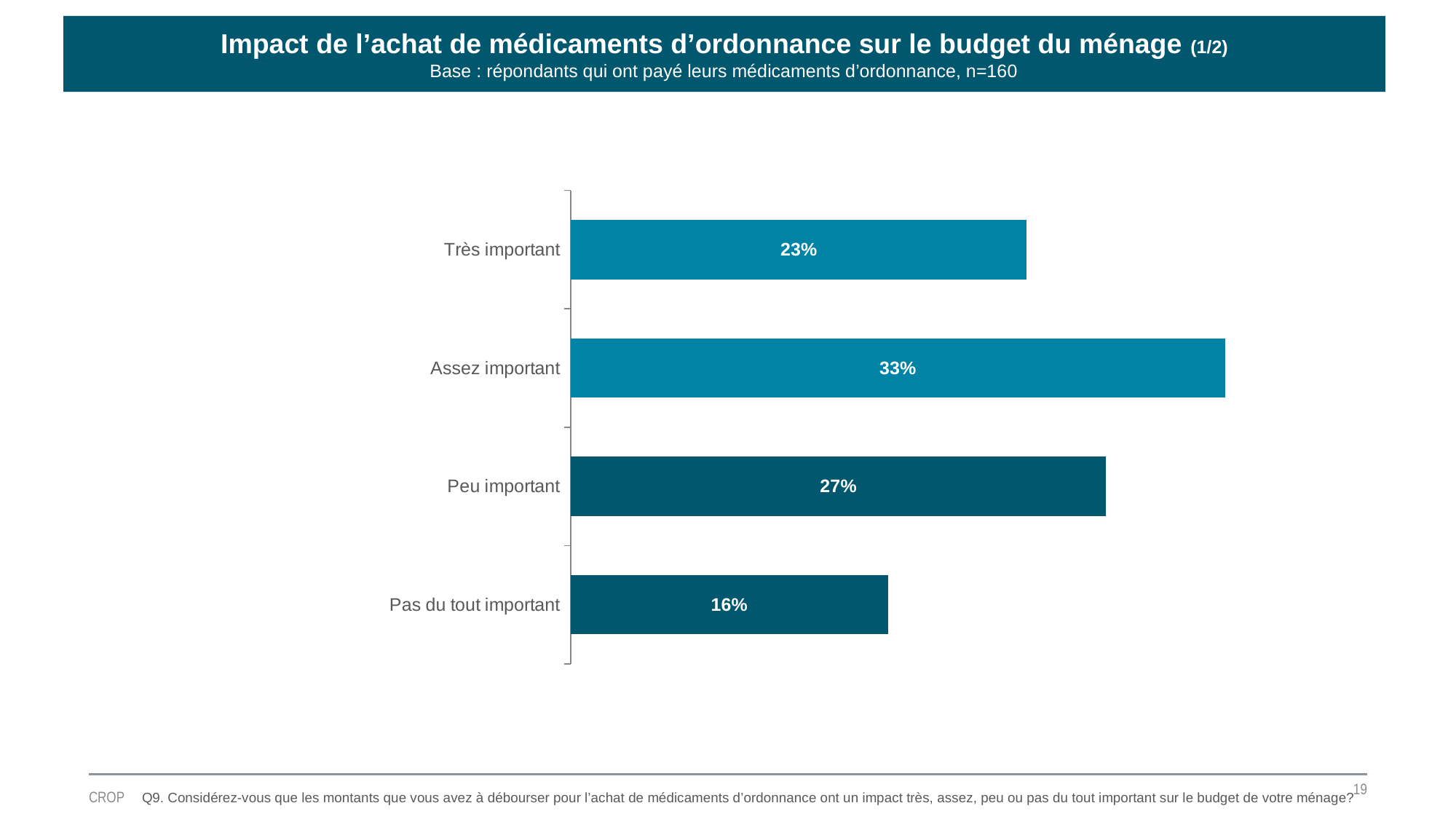
What is the base (n) stated in the chart's subtitle? n=160 What is the difference between the values for "Peu important" and "Pas du tout important"? 11% What is the value for "Assez important"? 33% What kind of chart is shown on the slide? Bar chart What is the value for "Pas du tout important"? 16% What is the value for "Peu important"? 27% How many categories are shown in the chart? 4 Which is larger, the value for "Peu important" or the value for "Très important"? Peu important What is the value for "Très important"? 23% What is the difference between the values for "Assez important" and "Très important"? 10% Which category has the highest value? Assez important Which category has the lowest value? Pas du tout important